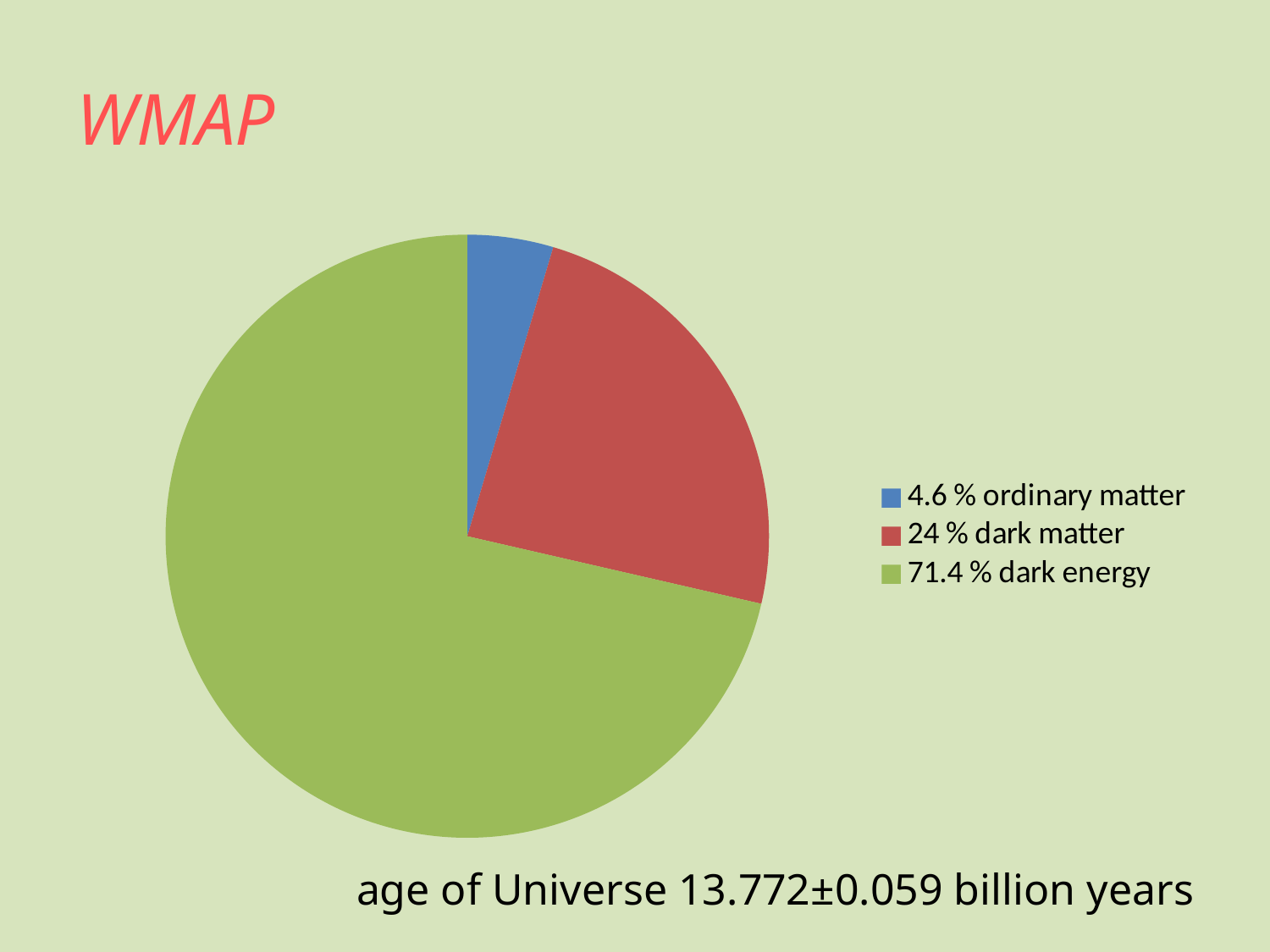
What is the title shown at the top of the slide? WMAP Which slice of the pie chart is the largest? dark energy What is the difference in percentage points between dark energy and dark matter? 47.4 What colour is the dark energy slice in the pie chart? green How many slices does the pie chart have? 3 What kind of chart is shown on the slide? pie chart What percentage of the pie is ordinary matter? 4.6 % Which slice of the pie chart is the smallest? ordinary matter Which is larger, the dark matter slice or the ordinary matter slice? dark matter What percentage of the pie is dark energy? 71.4 % What percentage of the pie is dark matter? 24 % What is the difference in percentage points between dark matter and ordinary matter? 19.4